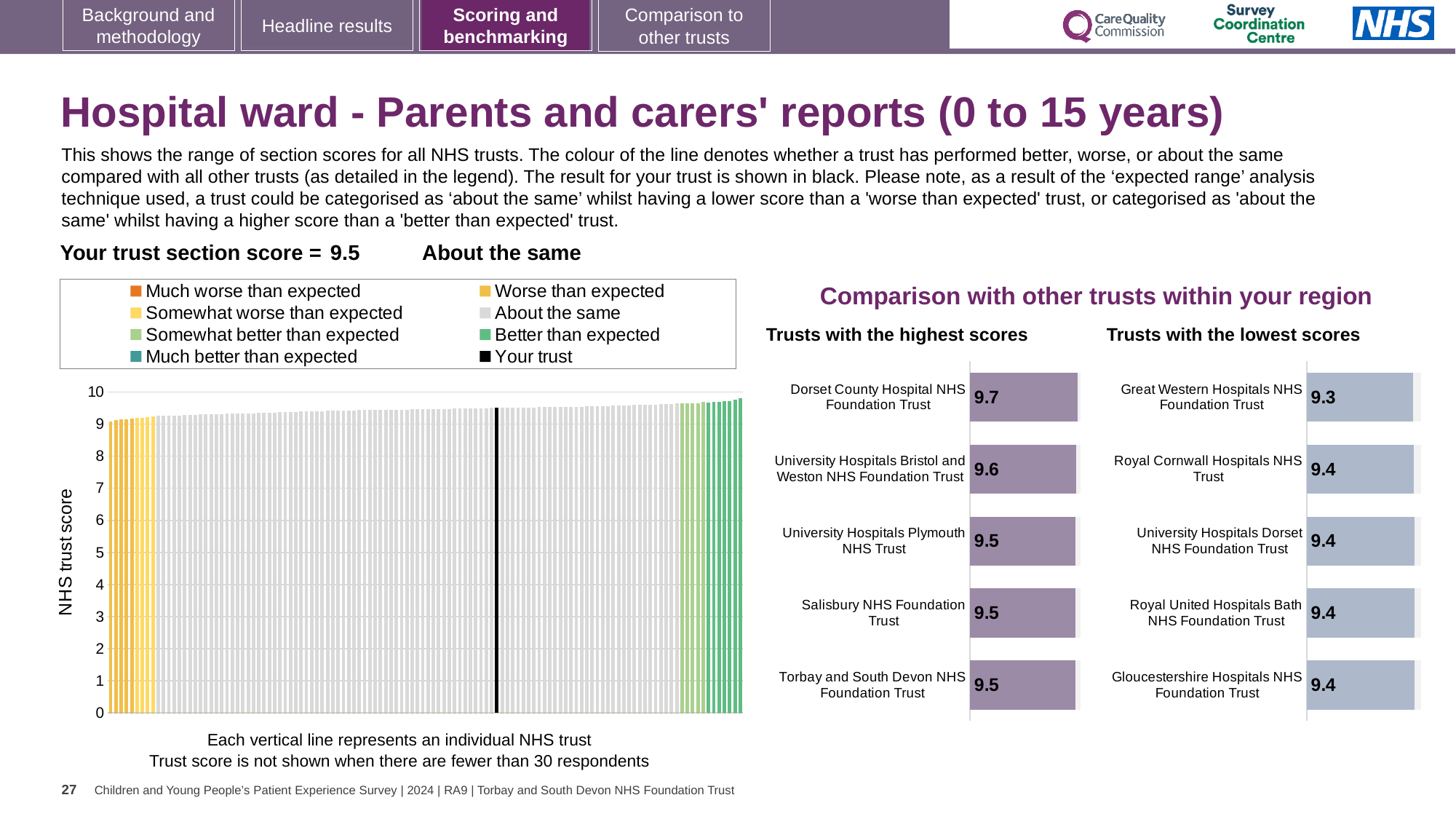
What kind of chart is the main 'NHS trust score' chart on the left? Bar chart In the 'Trusts with the lowest scores' chart, which trust has the lowest score? Great Western Hospitals NHS Foundation Trust How many trusts are shown in the 'Trusts with the highest scores' chart? 5 In the 'Trusts with the lowest scores' chart, what is the score for Great Western Hospitals NHS Foundation Trust? 9.3 Which is larger: the score for Dorset County Hospital NHS Foundation Trust in the highest scores chart, or the score for Great Western Hospitals NHS Foundation Trust in the lowest scores chart? Dorset County Hospital NHS Foundation Trust In the main 'NHS trust score' chart on the left, how many entries does the legend list? 8 In the 'Trusts with the highest scores' chart, what is the difference between the scores of Dorset County Hospital NHS Foundation Trust and Torbay and South Devon NHS Foundation Trust? 0.2 In the 'Trusts with the highest scores' chart, what is the score for University Hospitals Bristol and Weston NHS Foundation Trust? 9.6 In the 'Trusts with the lowest scores' chart, what is the score for Royal Cornwall Hospitals NHS Trust? 9.4 In the main 'NHS trust score' chart on the left, do the trust scores rise or fall from left to right along the x axis? Rise In the 'Trusts with the highest scores' chart, what is the score for Dorset County Hospital NHS Foundation Trust? 9.7 In the 'Trusts with the highest scores' chart, which trust has the highest score? Dorset County Hospital NHS Foundation Trust